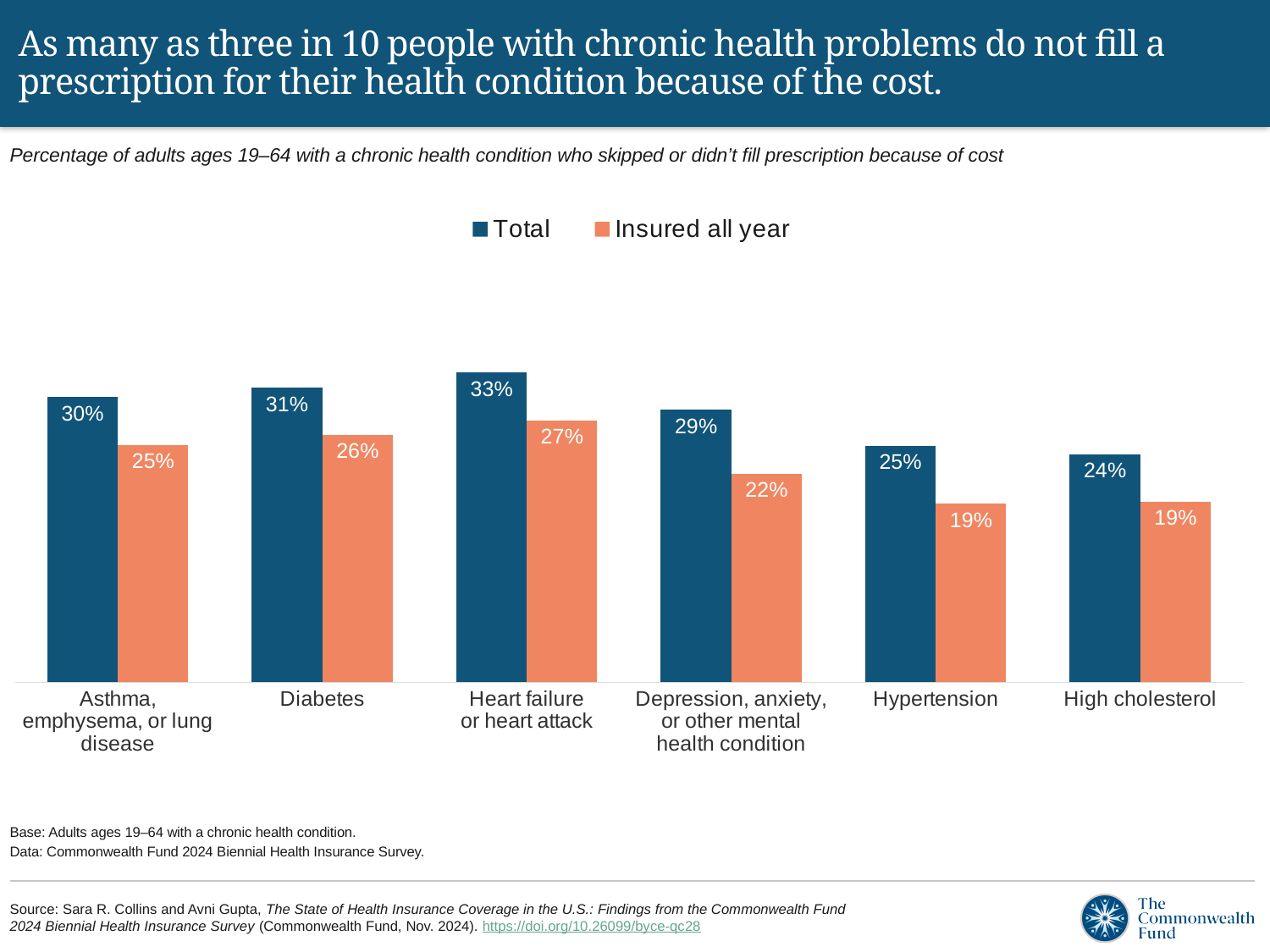
How many series does the legend list? 2 What is the difference between the Total and Insured all year values for Depression, anxiety, or other mental health condition? 7 percentage points What is the Insured all year value for Hypertension? 19% What kind of chart is shown on the slide? Bar chart Which series is shown in orange? Insured all year Which category has the highest Total value? Heart failure or heart attack Which category has the lowest Total value? High cholesterol Which is larger: the Total value for Diabetes or the Total value for Asthma, emphysema, or lung disease? Diabetes What is the Total value for High cholesterol? 24% What is the Total value for Heart failure or heart attack? 33% What is the Insured all year value for Diabetes? 26% How many categories are shown on the x axis? 6